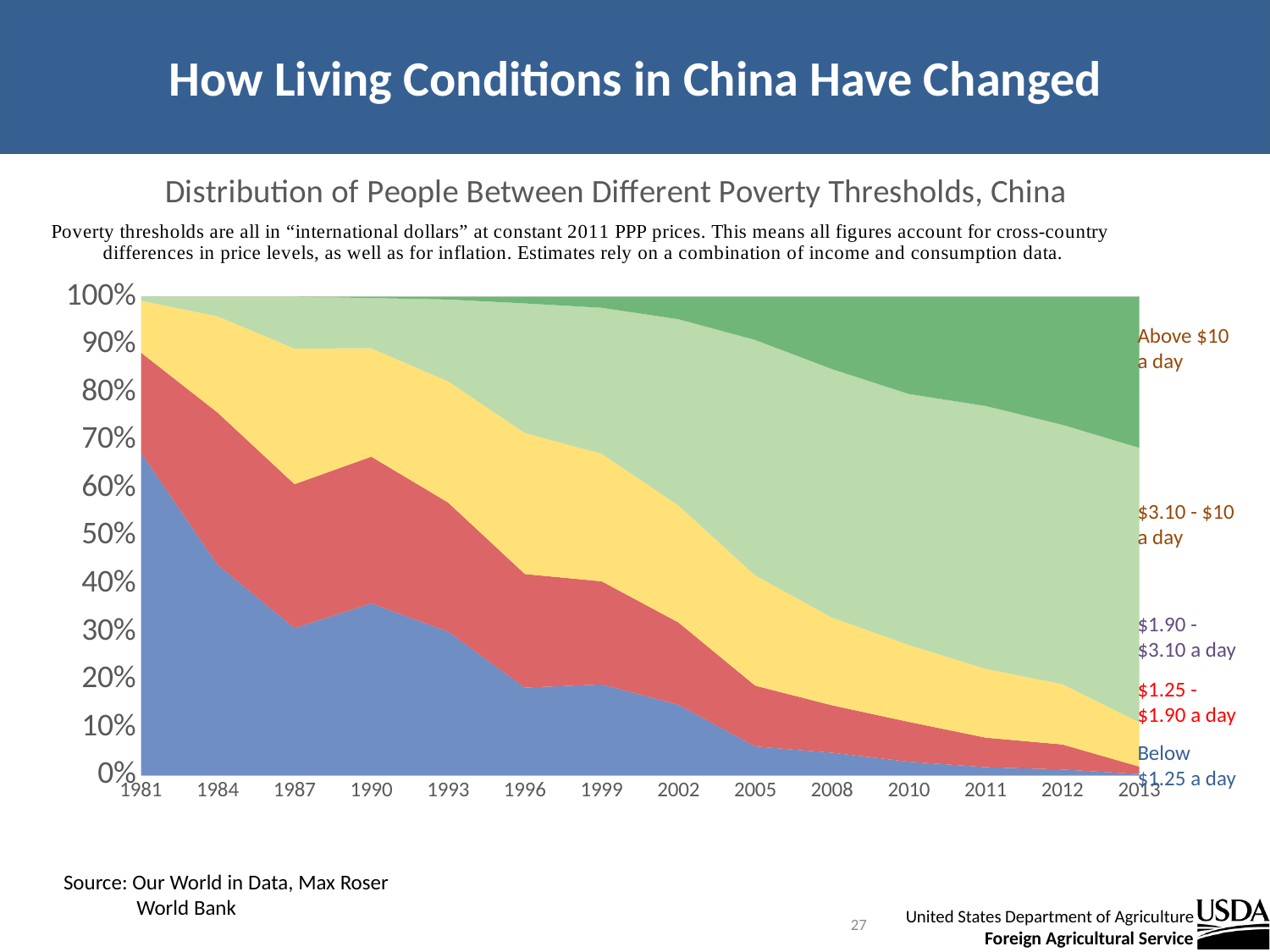
Is the share of people living below $1.25 a day in 2005 greater or less than 10%? less Is the share of people living below $1.25 a day in 1981 greater or less than 60%? greater Which year is the first one shown on the x axis? 1981 What is the title of the chart? Distribution of People Between Different Poverty Thresholds, China Is the share of people living below $1.25 a day in 2013 greater or less than 10%? less Does the share of people living below $1.25 a day rise or fall from 1981 to 2013? fall Does the share of people living above $10 a day rise or fall from 1981 to 2013? rise Which is larger in 1981: the share of people below $1.25 a day or the share above $10 a day? Below $1.25 a day What kind of chart is shown on the slide? stacked area chart How many poverty-threshold series are labelled on the chart? 5 How many years are labelled along the x axis of the chart? 14